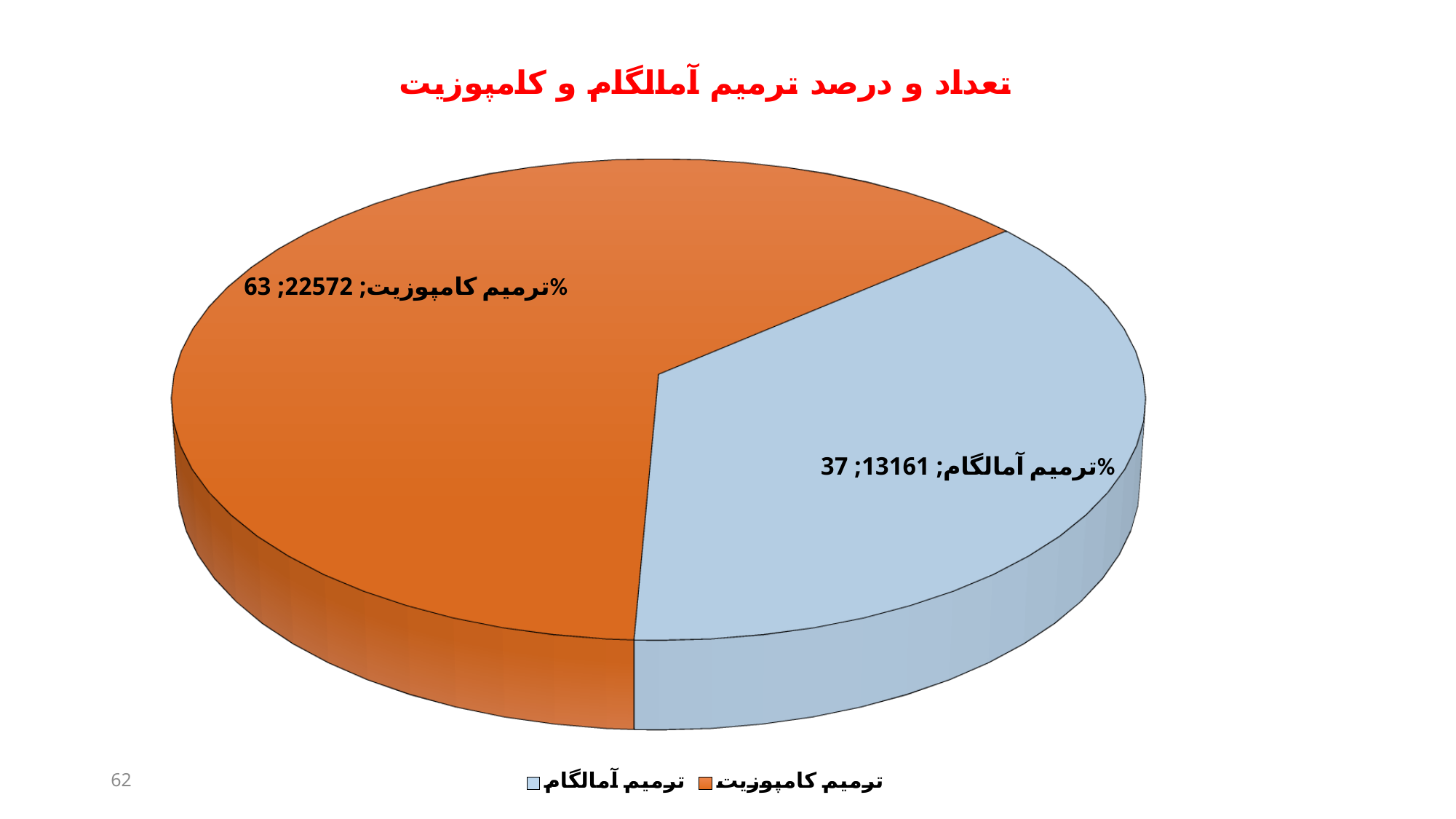
What percentage share of the pie does ترمیم کامپوزیت (composite restoration) have? 63% What is the value shown for ترمیم کامپوزیت (composite restoration)? 22572 What is the value shown for ترمیم آمالگام (amalgam restoration)? 13161 How many slices does the pie chart have? 2 What colour is the ترمیم آمالگام (amalgam restoration) slice? light blue What percentage share of the pie does ترمیم آمالگام (amalgam restoration) have? 37% Which slice is the largest in the pie chart? ترمیم کامپوزیت What is the difference between the values for ترمیم کامپوزیت and ترمیم آمالگام? 9411 Which is larger, the value for ترمیم کامپوزیت or the value for ترمیم آمالگام? ترمیم کامپوزیت How many entries does the legend list? 2 What kind of chart is shown on the slide? pie chart Which slice is the smallest in the pie chart? ترمیم آمالگام